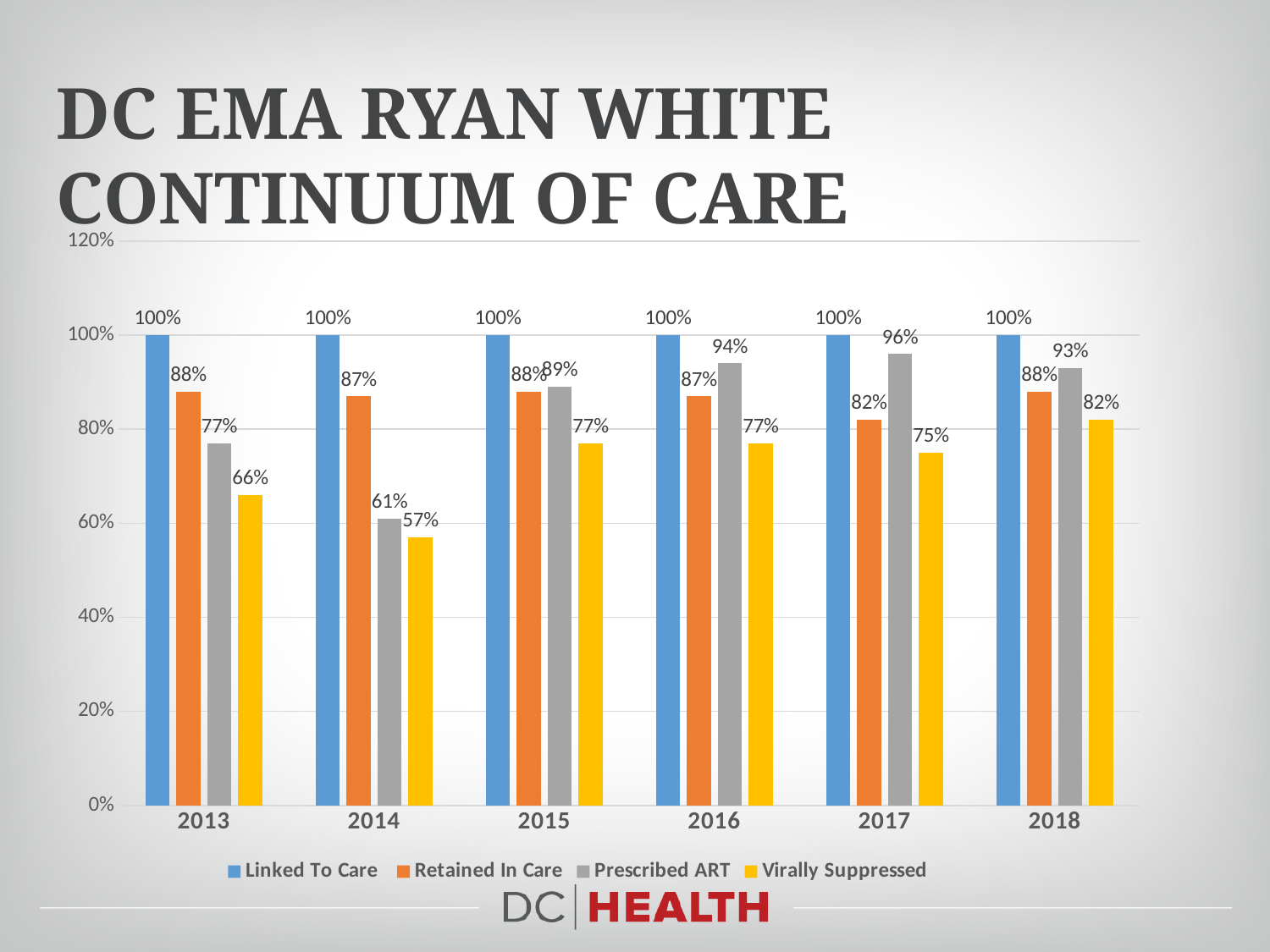
What is the Prescribed ART value for 2017? 96% What is the Retained In Care value for 2018? 88% Which colour represents Virally Suppressed in the legend? Yellow Which year has the highest Prescribed ART value? 2017 What is the difference between the Virally Suppressed values for 2018 and 2013? 16% How many years are shown on the x axis? 6 What is the Virally Suppressed value for 2014? 57% How many series does the legend list? 4 Which is larger, the Retained In Care value for 2017 or the Retained In Care value for 2016? 2016 Which year has the lowest Virally Suppressed value? 2014 What kind of chart is shown on the slide? Bar chart Does the Prescribed ART value rise or fall from 2014 to 2017? Rise